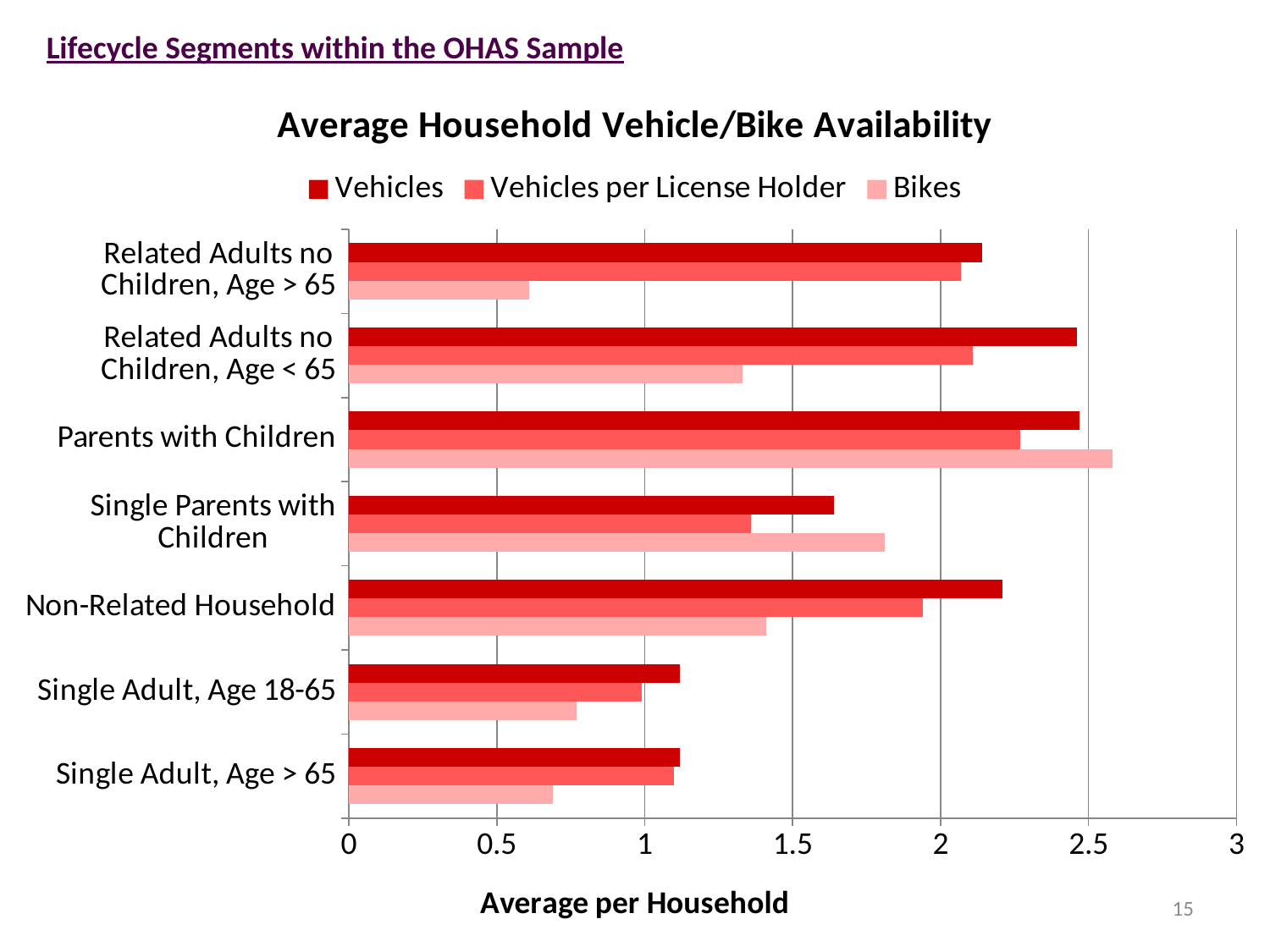
Is the Bikes value for Related Adults no Children, Age > 65 greater or less than 1? less How many household lifecycle categories are plotted on the chart? 7 Which category has the highest Vehicles per License Holder value? Parents with Children For Single Parents with Children, which is larger: the Bikes value or the Vehicles value? Bikes Is the Vehicles value for Single Parents with Children greater or less than 1.5? greater What is the title of the horizontal axis? Average per Household What kind of chart is shown on the slide? Bar chart Is the Vehicles value for Non-Related Household greater or less than 2? greater Which category has the highest Bikes value? Parents with Children For Non-Related Household, which is larger: the Vehicles value or the Bikes value? Vehicles How many series does the legend list? 3